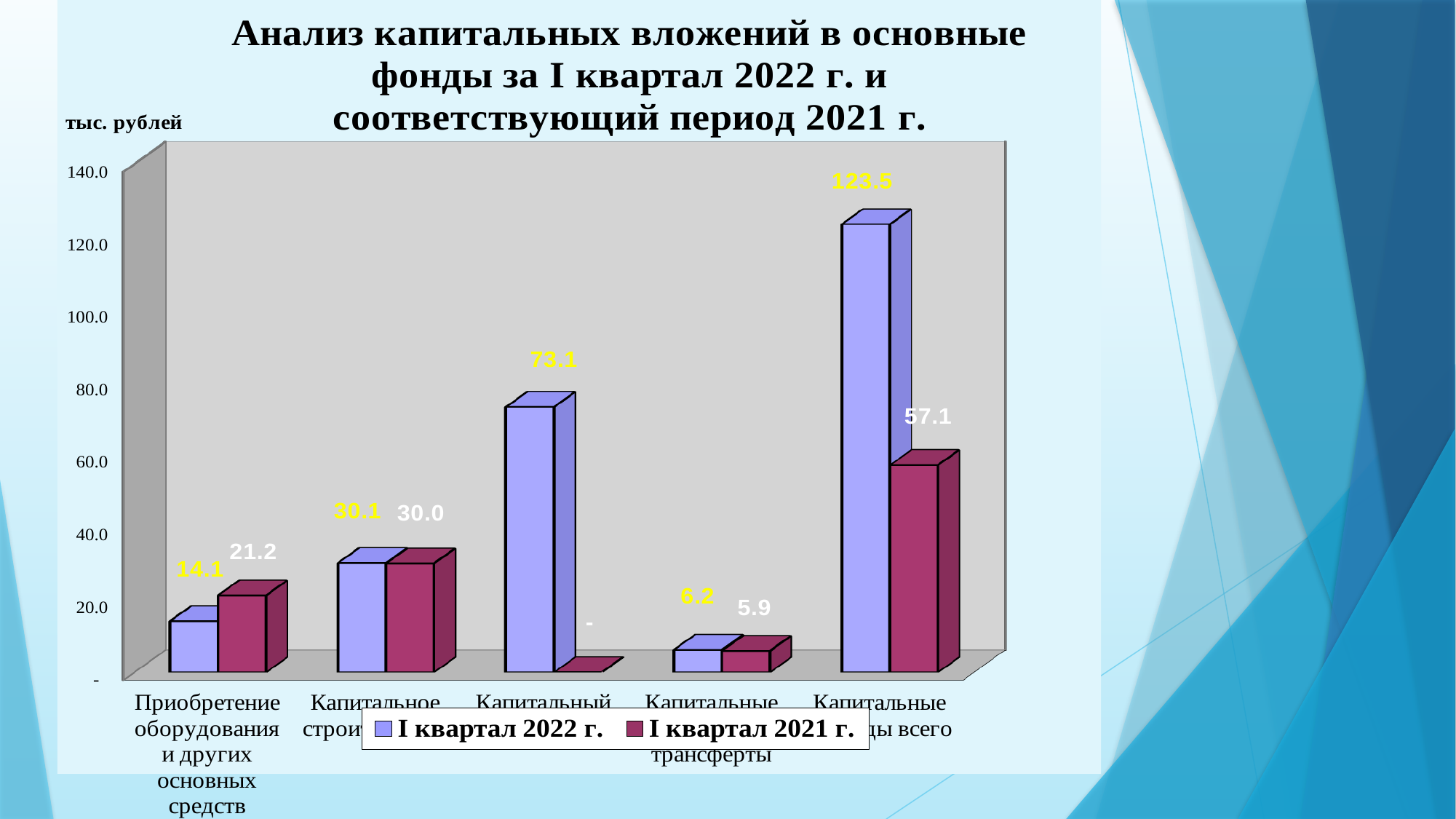
Which category has the lowest value for I квартал 2022 г.? Капитальные трансферты What unit is shown above the vertical axis? тыс. рублей What is the highest value in the I квартал 2022 г. series? 123.5 In the rightmost category, what is the difference between the I квартал 2022 г. value and the I квартал 2021 г. value? 66.4 What is the value for I квартал 2022 г. in the third category from the left? 73.1 In the category 'Приобретение оборудования и других основных средств', which series has the larger value? I квартал 2021 г. What is the value for I квартал 2021 г. in the category 'Приобретение оборудования и других основных средств'? 21.2 What is the value for I квартал 2022 г. in the category 'Приобретение оборудования и других основных средств'? 14.1 How many categories are plotted along the x axis? 5 How many series does the legend list? 2 What kind of chart is shown on the slide? Bar chart What is the value for I квартал 2021 г. in the category 'Капитальные трансферты'? 5.9